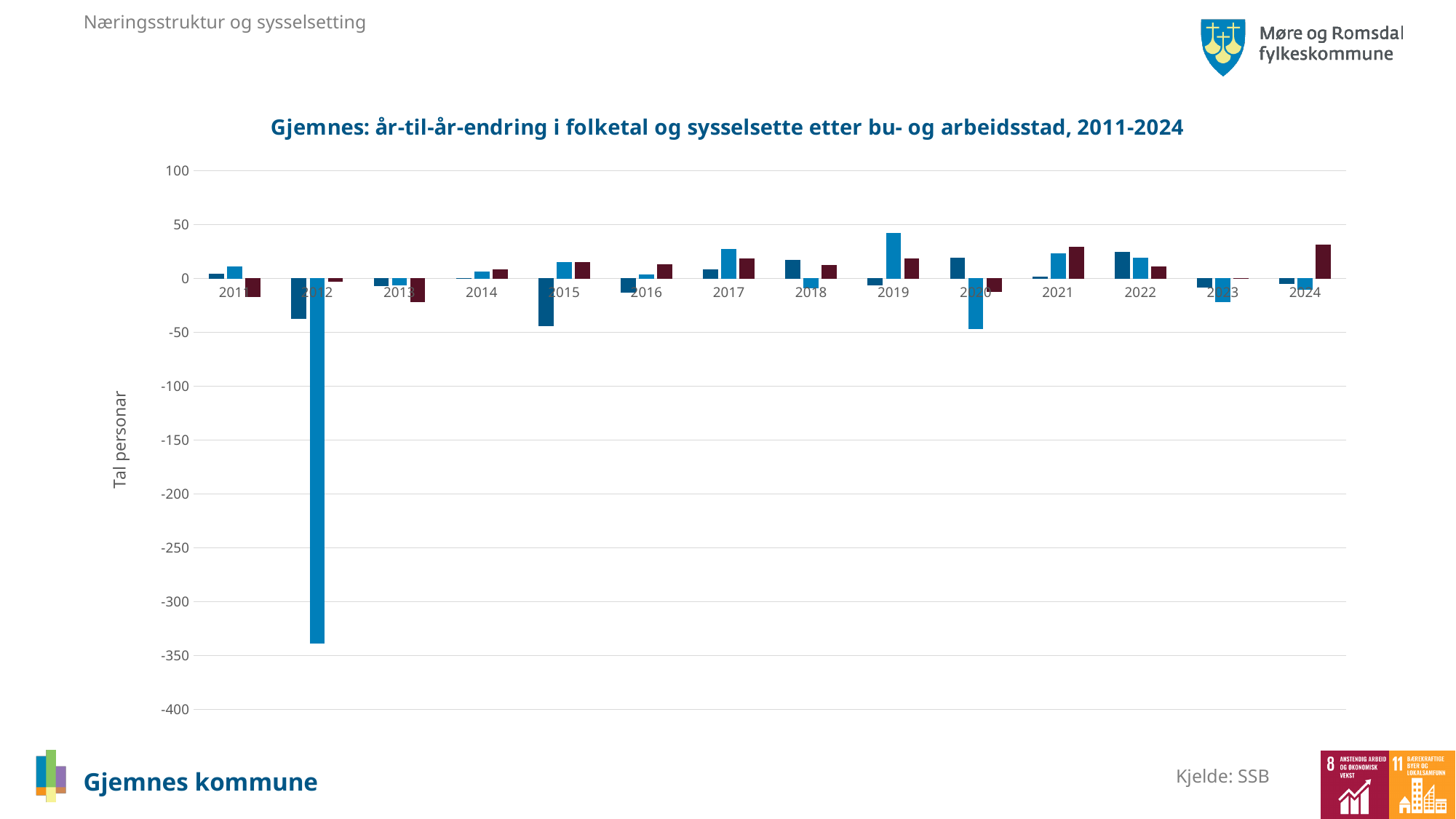
What is the title of the chart? Gjemnes: år-til-år-endring i folketal og sysselsette etter bu- og arbeidsstad, 2011-2024 Is the value of the dark red bar in 2024 greater or less than 20? greater Which is larger: the dark red bar in 2024 or the dark red bar in 2022? 2024 What is the label on the vertical axis of the chart? Tal personar Is the value of the light blue bar in 2020 greater or less than -30? less In which year does the light blue bar reach its lowest value? 2012 Is the value of the light blue bar in 2012 greater or less than -300? less What kind of chart is shown on the slide? bar chart Which is larger: the light blue bar in 2019 or the light blue bar in 2017? 2019 How many years are shown along the x axis of the chart? 14 In which year does the light blue bar reach its highest value? 2019